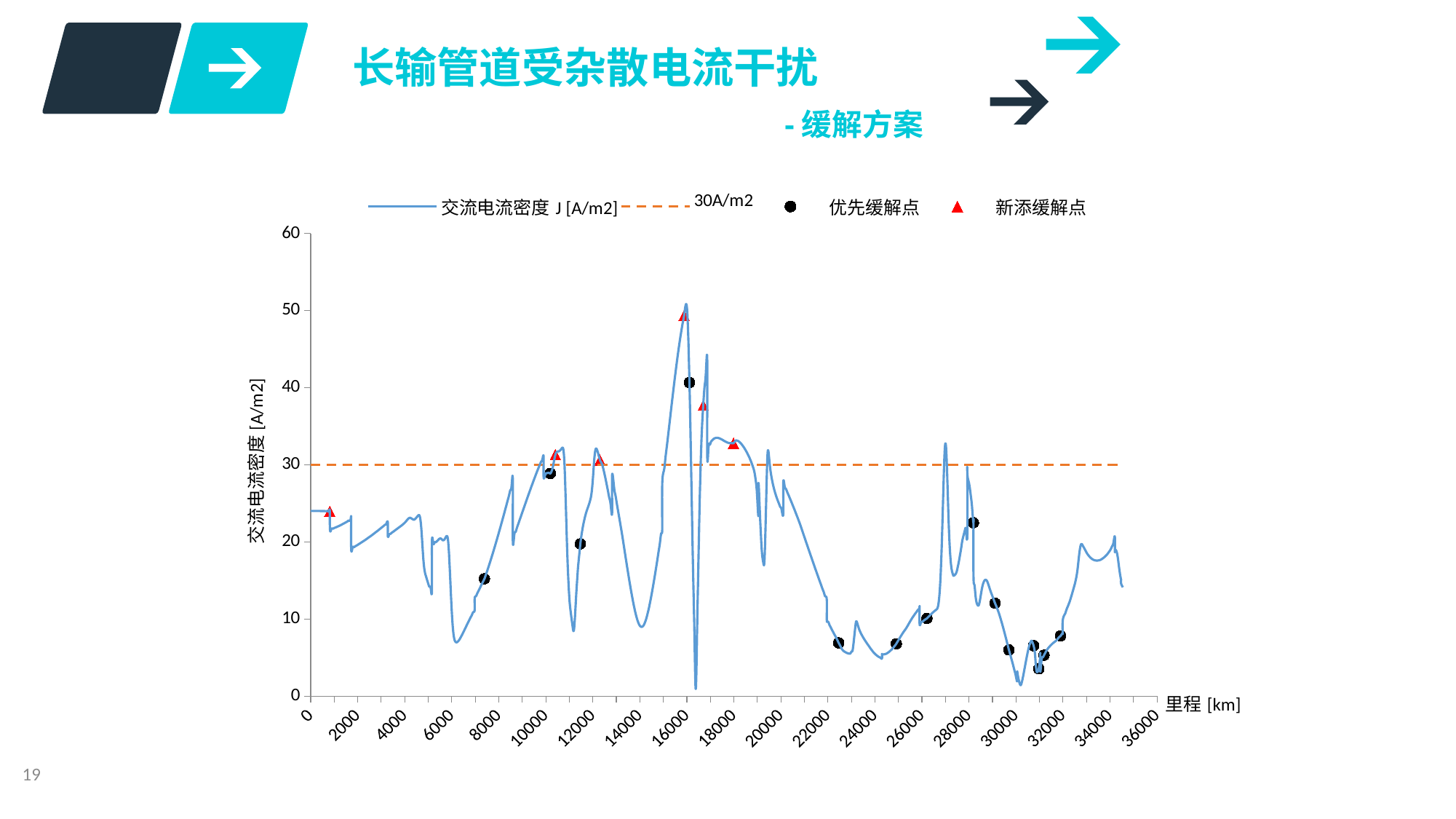
Is the value of 交流电流密度 at 0 km greater or less than 30? less What is the label of the x-axis? 里程 [km] Near which x-axis tick does the highest peak of 交流电流密度 occur? 16000 What is the highest tick value shown on the y-axis? 60 What is the label of the y-axis? 交流电流密度 [A/m2] Which is larger: the peak of 交流电流密度 near 16000 km or the peak near 28000 km? the peak near 16000 km Is the value of 交流电流密度 near 24000 km greater or less than 10? less What value does the dashed horizontal reference line represent, according to the legend? 30A/m2 Is the peak value of 交流电流密度 near 16000 km greater or less than 40? greater What kind of chart is shown on the slide? line chart How many entries does the legend list? 4